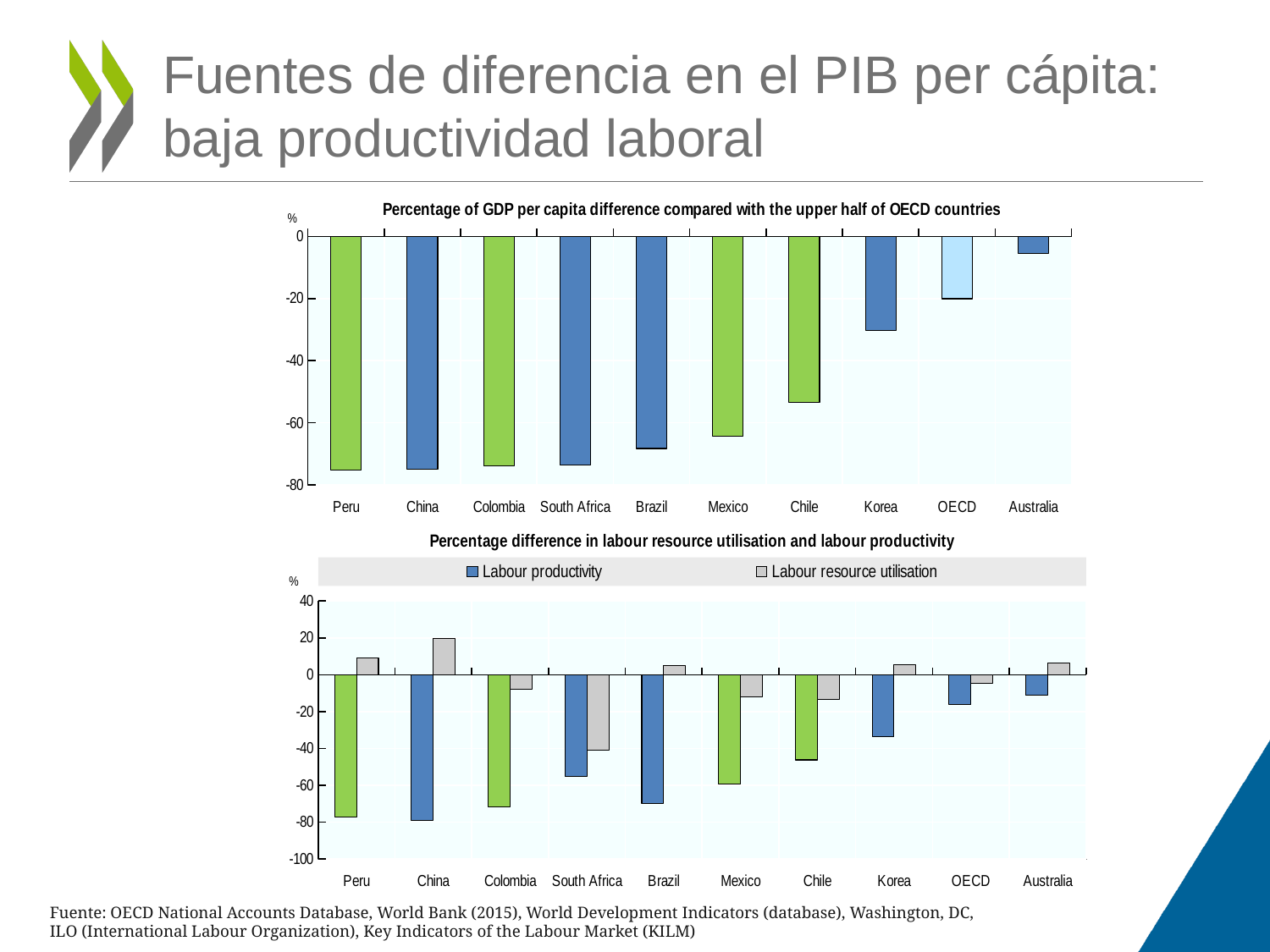
In the top chart, which category has the value closest to zero (the highest value)? Australia In the bottom chart, which has the larger Labour productivity value, Korea or Chile? Korea In the bottom chart, what are the two series named in the legend? Labour productivity and Labour resource utilisation In the top chart, which has the larger (less negative) value, Korea or Chile? Korea What kind of chart is the top chart, 'Percentage of GDP per capita difference compared with the upper half of OECD countries'? Bar chart In the bottom chart, is the Labour productivity value for China greater or less than -60? less In the top chart, is the value for Korea greater or less than -40? greater In the top chart, how many countries or groups are shown on the x axis? 10 In the bottom chart, which country has the lowest Labour resource utilisation value? South Africa In the bottom chart, which country has the highest Labour resource utilisation value? China In the top chart, is the value for Chile greater or less than -40? less In the bottom chart, 'Percentage difference in labour resource utilisation and labour productivity', how many series does the legend list? 2